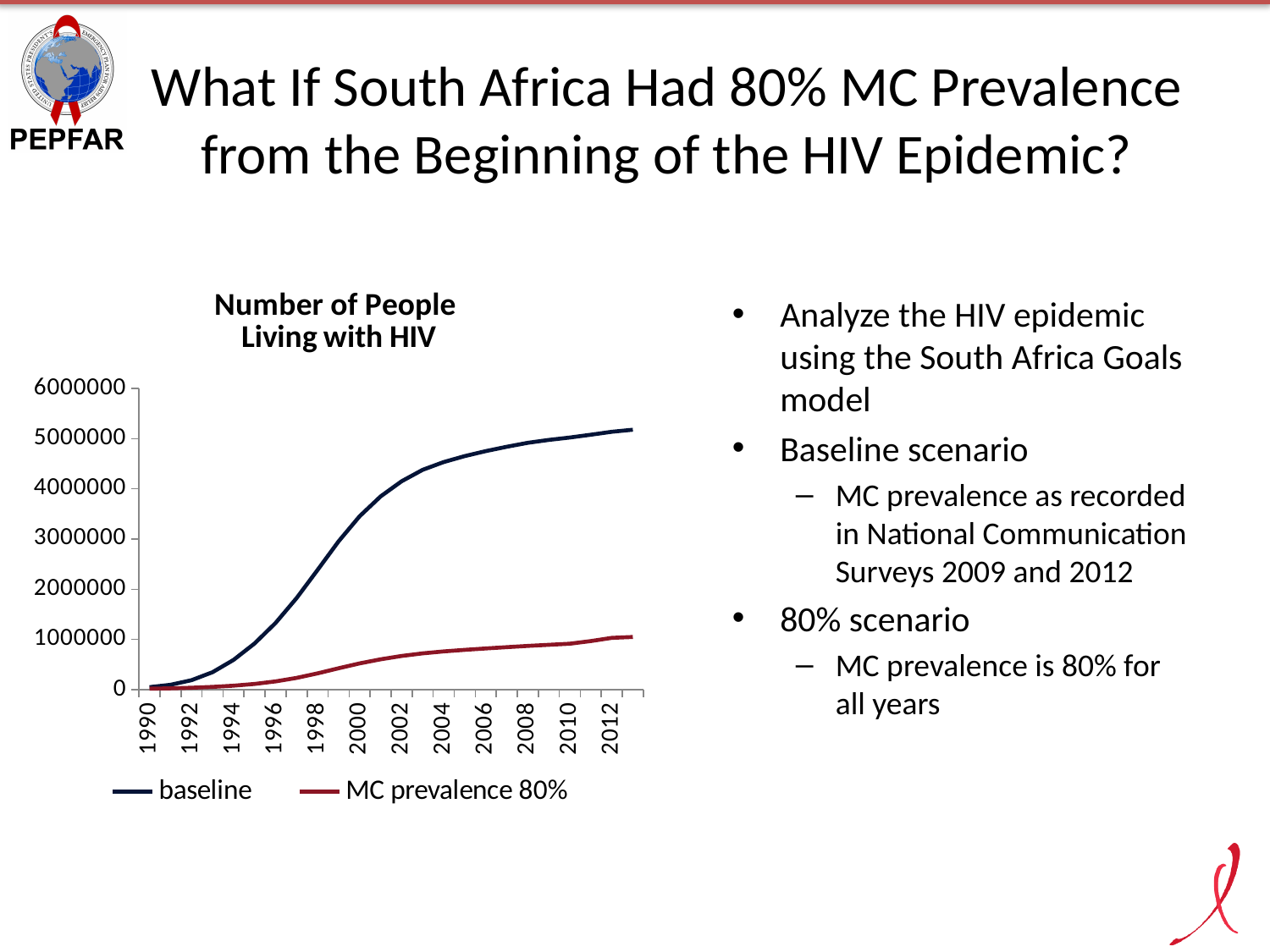
Is the baseline value for 2012 greater or less than 4000000? greater Is the baseline value for 2004 greater or less than 4000000? greater Is the MC prevalence 80% value for 2012 greater or less than 2000000? less How many series does the legend of the chart list? 2 How many year labels are shown on the x axis of the chart? 12 Does the MC prevalence 80% series rise or fall from 1990 to 2012? rise What is the title of the chart? Number of People Living with HIV What kind of chart is shown on the slide? line chart Does the baseline series rise or fall from 1990 to 2012? rise Which series is drawn in dark red in the chart? MC prevalence 80% Which series has the higher value in 2012, baseline or MC prevalence 80%? baseline